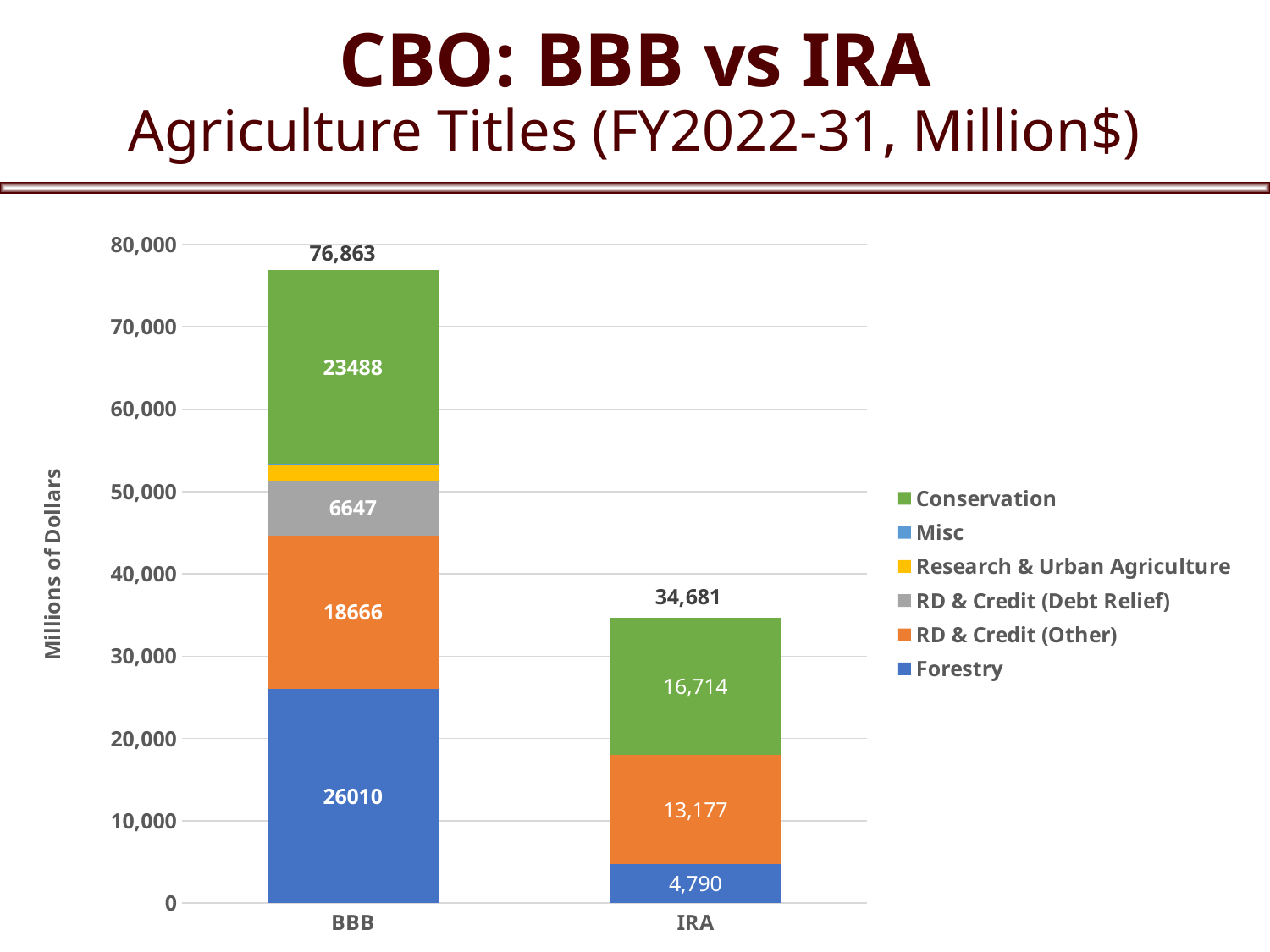
What is the Forestry value for BBB? 26010 What is the total of the IRA stacked bar? 34,681 What is the total of the BBB stacked bar? 76,863 Is the total for IRA greater or less than 30,000? greater What kind of chart is shown on the slide? Stacked bar chart Which has the larger RD & Credit (Other) value, BBB or IRA? BBB What is the Conservation value for IRA? 16,714 How many series does the legend list? 6 How many bars (categories) are plotted on the x axis? 2 What is the difference between the Conservation values for BBB and IRA? 6,774 What is the title of the y axis? Millions of Dollars What is the RD & Credit (Debt Relief) value for BBB? 6647